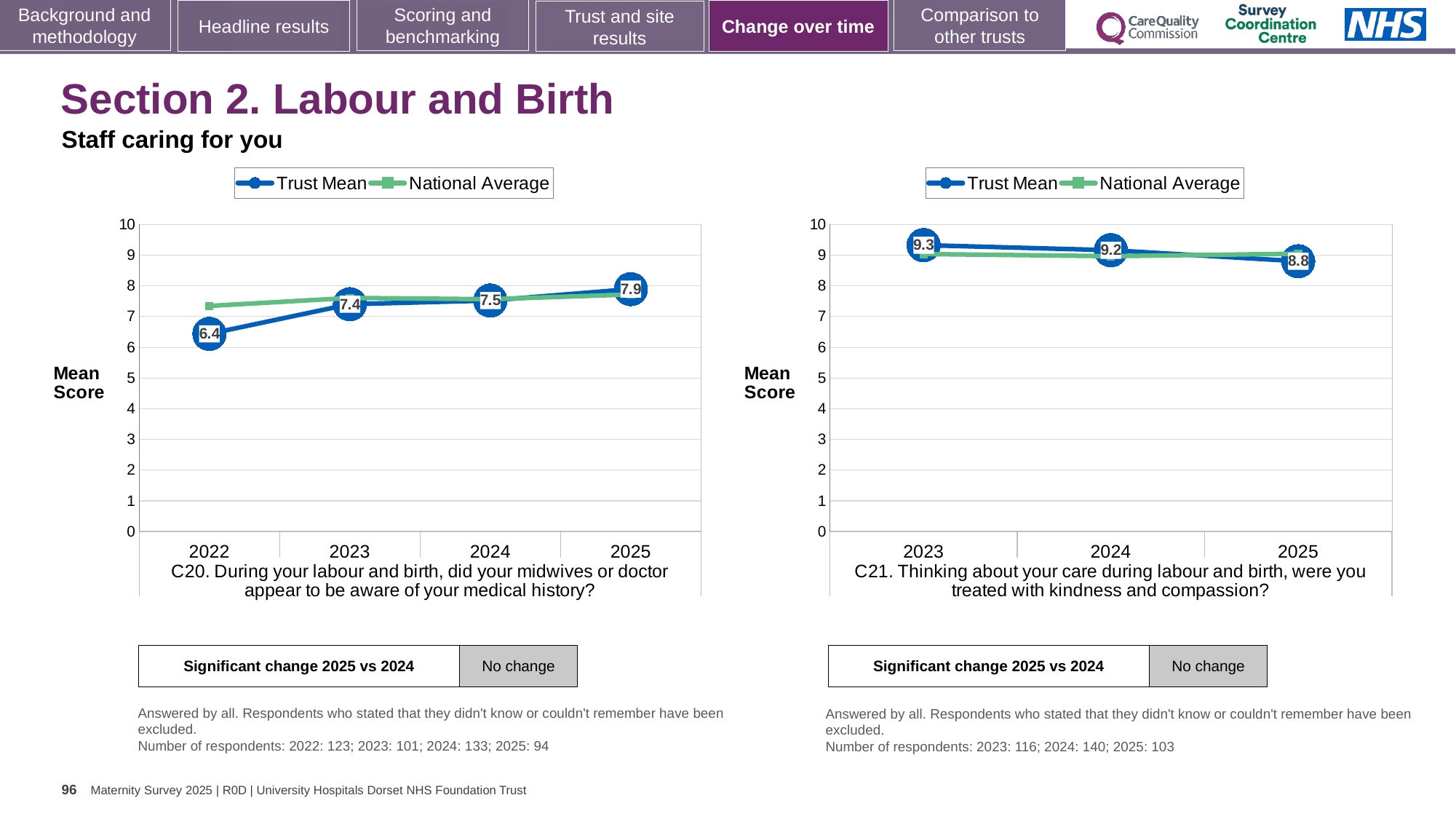
On the C20 chart (left), which year has the lowest Trust Mean score? 2022 How many series does the legend of the C20 chart (left) list? 2 On the C20 chart (left), what is the Trust Mean score for 2022? 6.4 On the C20 chart (left), what is the Trust Mean score for 2025? 7.9 On the C21 chart (right), what is the Trust Mean score for 2023? 9.3 On the C20 chart (left), what is the difference between the Trust Mean scores for 2025 and 2022? 1.5 On the C21 chart (right), is the Trust Mean score for 2024 greater or less than 9? greater On the C20 chart (left), does the Trust Mean rise or fall from 2022 to 2025? rise On the C21 chart (right), how many years are shown on the x axis? 3 On the C21 chart (right), what is the Trust Mean score for 2025? 8.8 On the C21 chart (right), which year has the highest Trust Mean score? 2023 What kind of chart is the C21 chart (right)? line chart